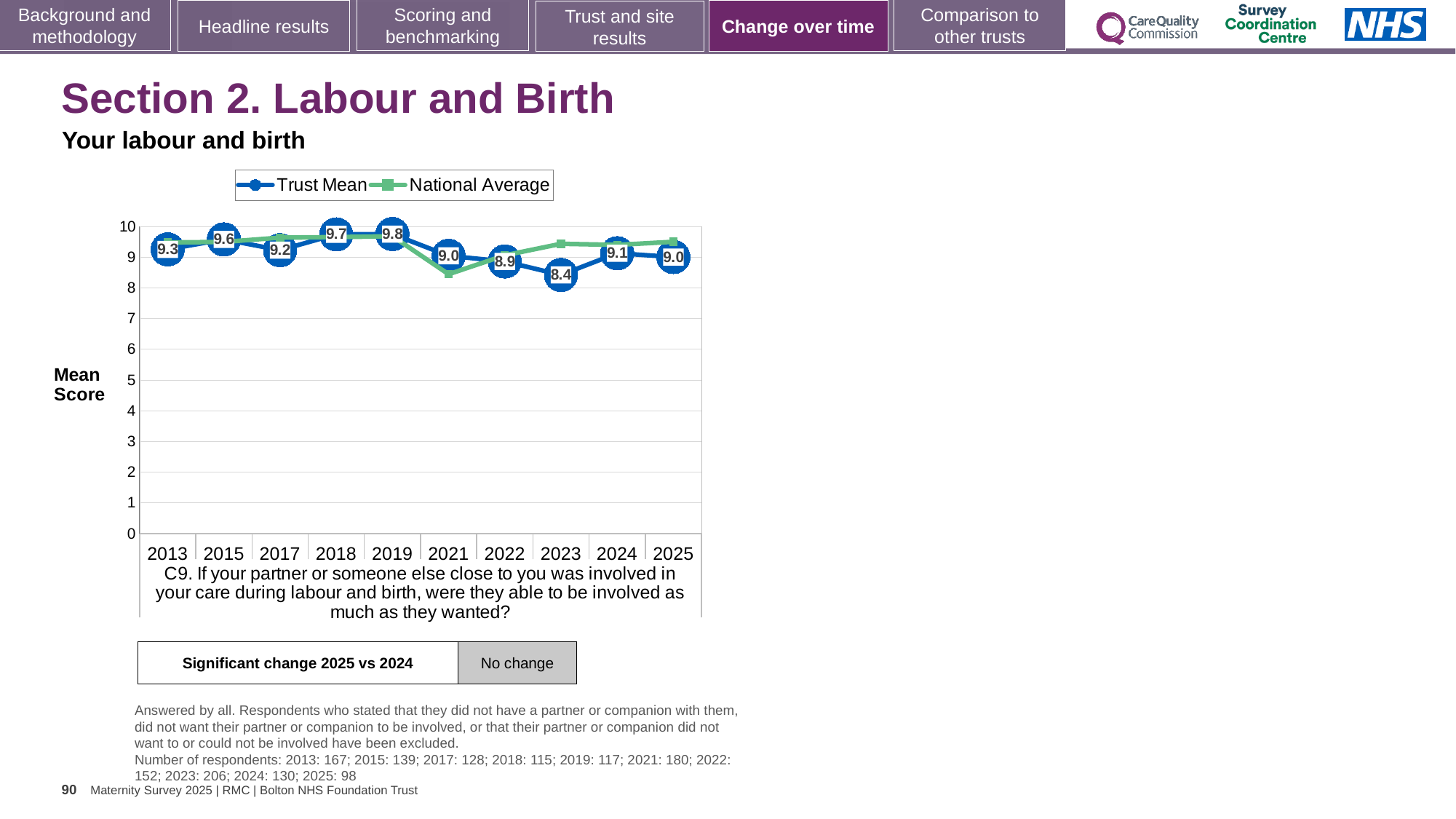
In which year is the Trust Mean highest? 2019 In which year is the Trust Mean lowest? 2023 Is the National Average value for 2021 greater or less than 9? less Does the Trust Mean rise or fall from 2019 to 2023? fall What is the difference between the Trust Mean in 2019 and in 2023? 1.4 What kind of chart is shown on the slide? line chart Which year has the higher Trust Mean, 2015 or 2022? 2015 How many series does the legend list? 2 What is the Trust Mean score for 2023? 8.4 What is the Trust Mean score for 2019? 9.8 What is the Trust Mean score for 2025? 9.0 How many years are shown on the x axis? 10